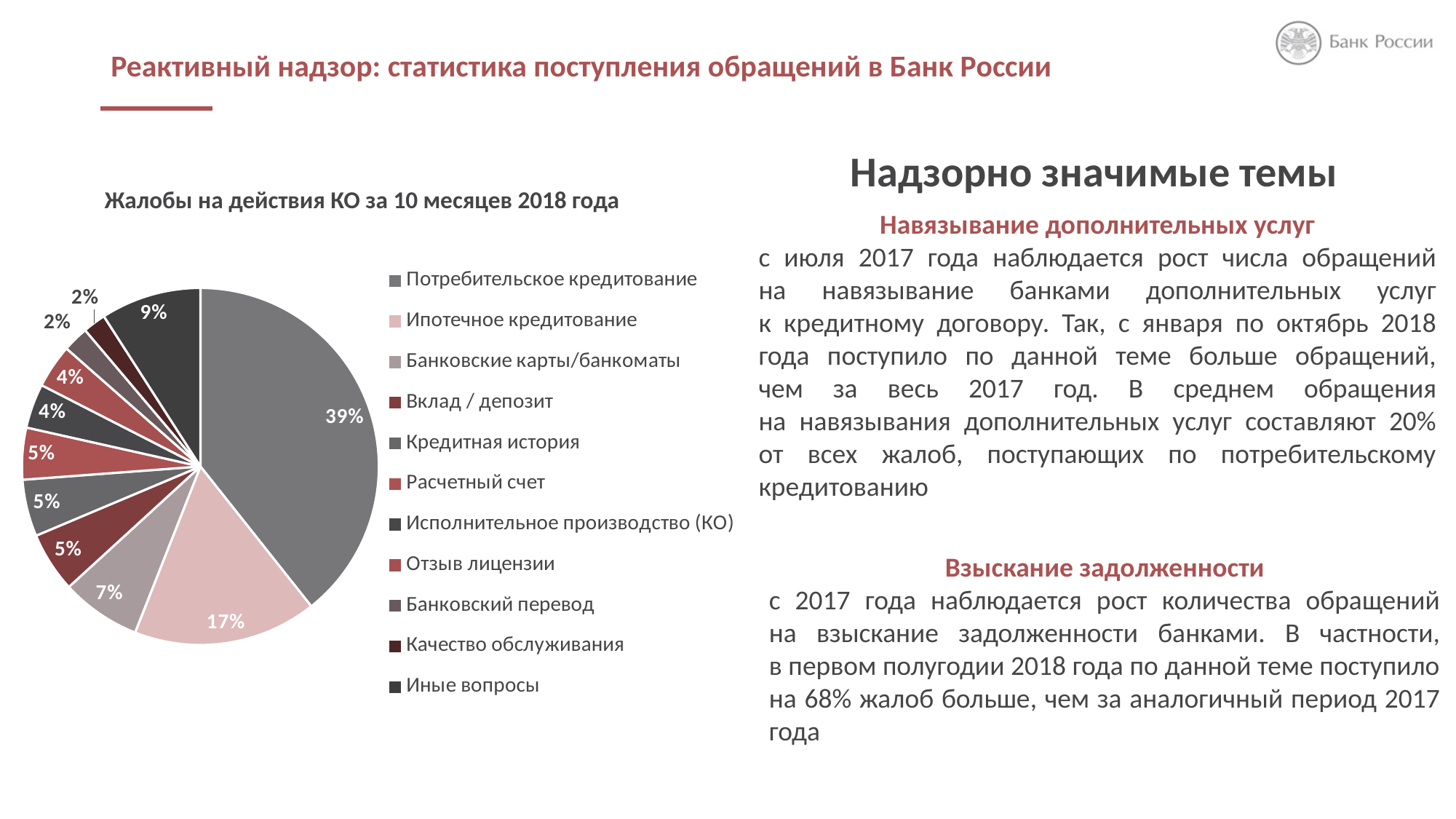
Which has a larger share: Иные вопросы or Банковские карты/банкоматы? Иные вопросы What share of complaints is attributed to Банковские карты/банкоматы? 7% What share of complaints is attributed to Иные вопросы? 9% What kind of chart is shown on the slide? Pie chart What share of complaints is attributed to Потребительское кредитование? 39% What share of complaints is attributed to Качество обслуживания? 2% What is the combined share of Потребительское кредитование and Ипотечное кредитование? 56% Which category has the largest share of the pie? Потребительское кредитование What is the difference in percentage points between Потребительское кредитование and Ипотечное кредитование? 22 What is the title of the pie chart? Жалобы на действия КО за 10 месяцев 2018 года What share of complaints is attributed to Ипотечное кредитование? 17% How many categories does the pie chart's legend list? 11